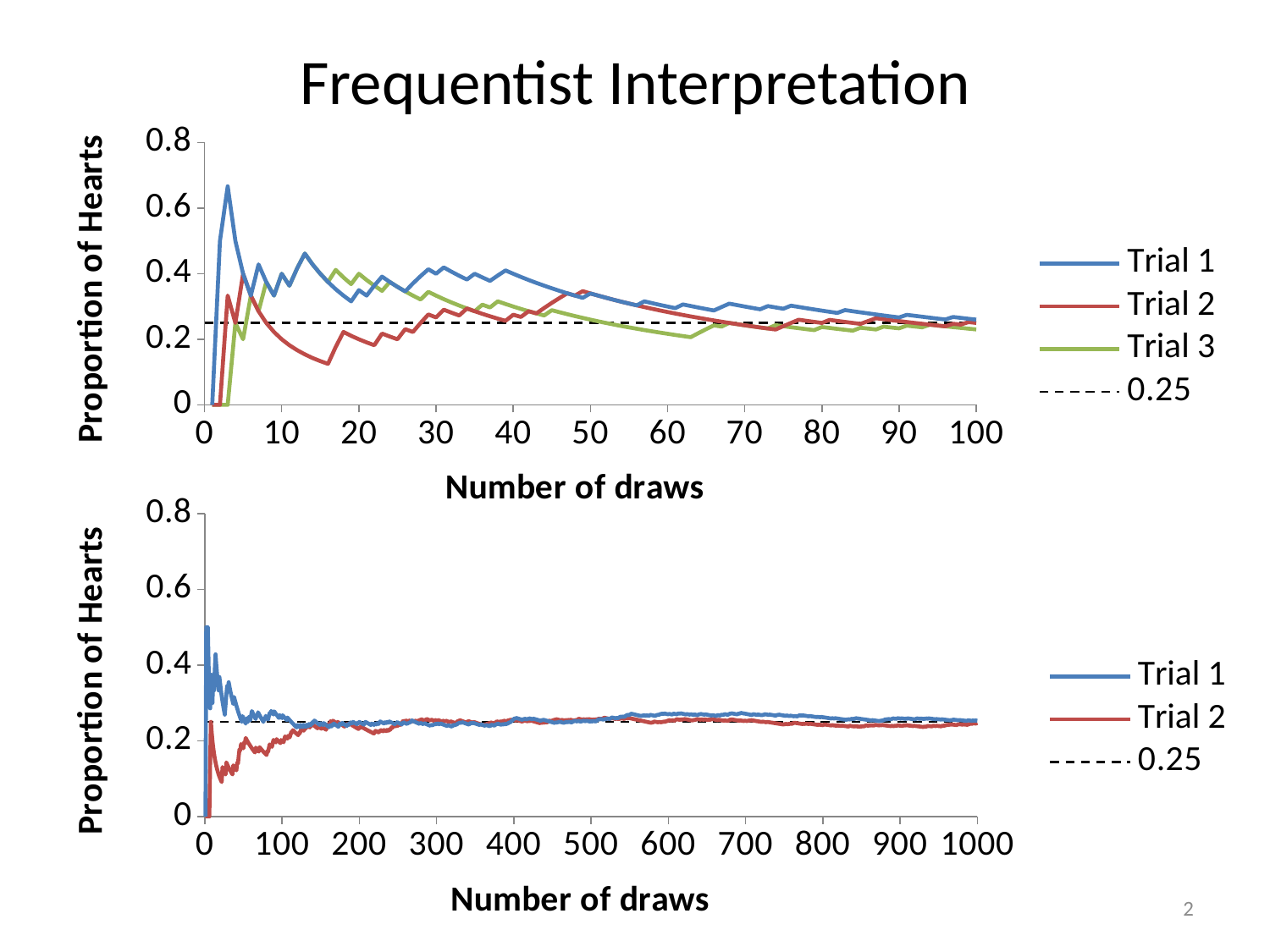
In the top chart, is the value for Trial 1 at 3 draws greater or less than 0.6? greater In the top chart, at 10 draws, which is larger: Trial 1 or Trial 2? Trial 1 How many series does the legend of the top chart list? 4 How many series does the legend of the bottom chart list? 3 What value does the dashed horizontal line in both charts represent? 0.25 In the top chart, which trial has the lowest proportion of hearts at around 15 draws? Trial 2 In the top chart, which trial reaches the highest proportion of hearts? Trial 1 In the bottom chart, at 50 draws, which is larger: Trial 1 or Trial 2? Trial 1 In the top chart, does Trial 2 rise or fall between 15 and 50 draws? rise In the bottom chart, is the value for Trial 2 at 20 draws greater or less than 0.2? less What kind of chart is the top chart on the slide? Line chart In the top chart, is the value for Trial 2 at 15 draws greater or less than 0.2? less